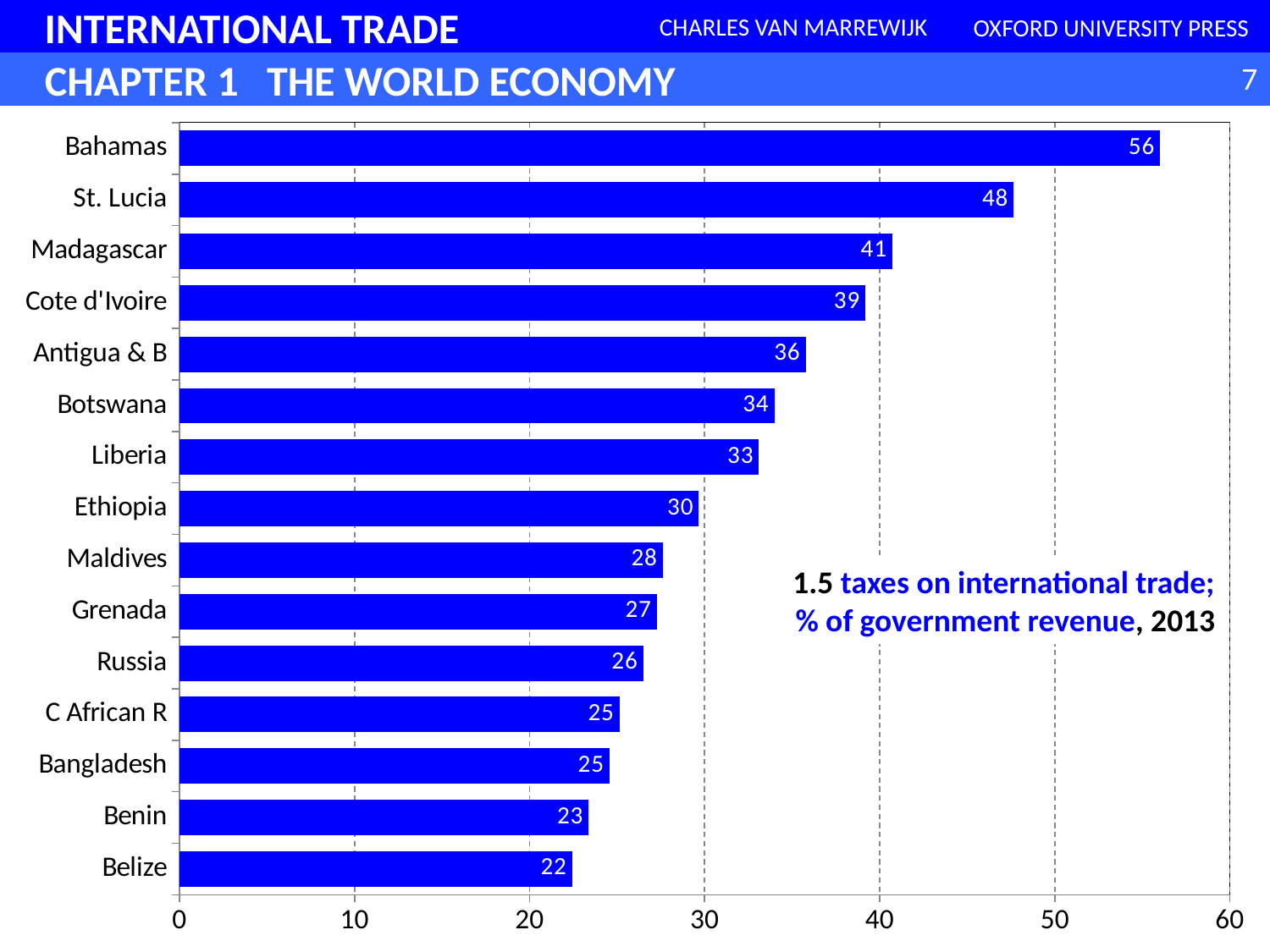
What is the value for Bahamas? 56 Which country has the highest value? Bahamas What is the difference between the values for Bahamas and Belize? 34 How many countries are shown in the chart? 15 What is the value for Russia? 26 What is the difference between the values for St. Lucia and Cote d'Ivoire? 9 What kind of chart is shown on the slide? bar chart What is the value for Madagascar? 41 Which is larger, the value for Botswana or the value for Ethiopia? Botswana Which country has the lowest value? Belize What year does the chart's data refer to? 2013 Is the value for Liberia greater or less than 30? greater